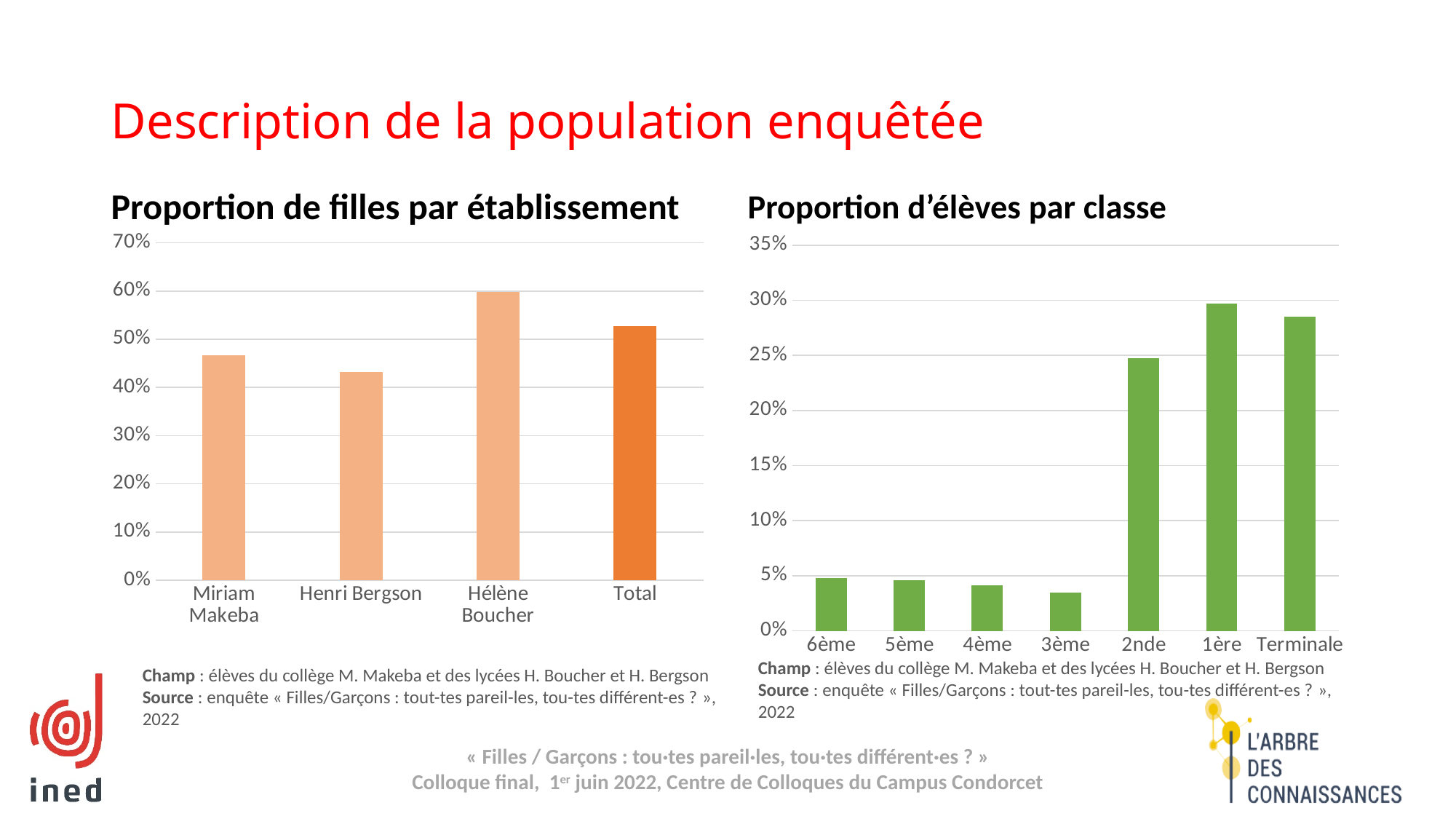
In the chart "Proportion de filles par établissement", is the value for Total greater or less than 50%? greater In the chart "Proportion de filles par établissement", is the value for Miriam Makeba greater or less than 50%? less In the chart "Proportion de filles par établissement", which is larger, the value for Miriam Makeba or the value for Henri Bergson? Miriam Makeba In the chart "Proportion d'élèves par classe", is the value for 2nde greater or less than 20%? greater How many categories are shown in the chart "Proportion de filles par établissement"? 4 In the chart "Proportion de filles par établissement", which establishment has the highest proportion of girls? Hélène Boucher In the chart "Proportion de filles par établissement", which establishment has the lowest proportion of girls? Henri Bergson In the chart "Proportion de filles par établissement", which bar is shown in a darker orange colour than the others? Total In the chart "Proportion d'élèves par classe", which class has the lowest proportion of students? 3ème How many categories are shown in the chart "Proportion d'élèves par classe"? 7 What type of chart is "Proportion de filles par établissement"? bar chart In the chart "Proportion d'élèves par classe", which is larger, the value for 1ère or the value for 4ème? 1ère